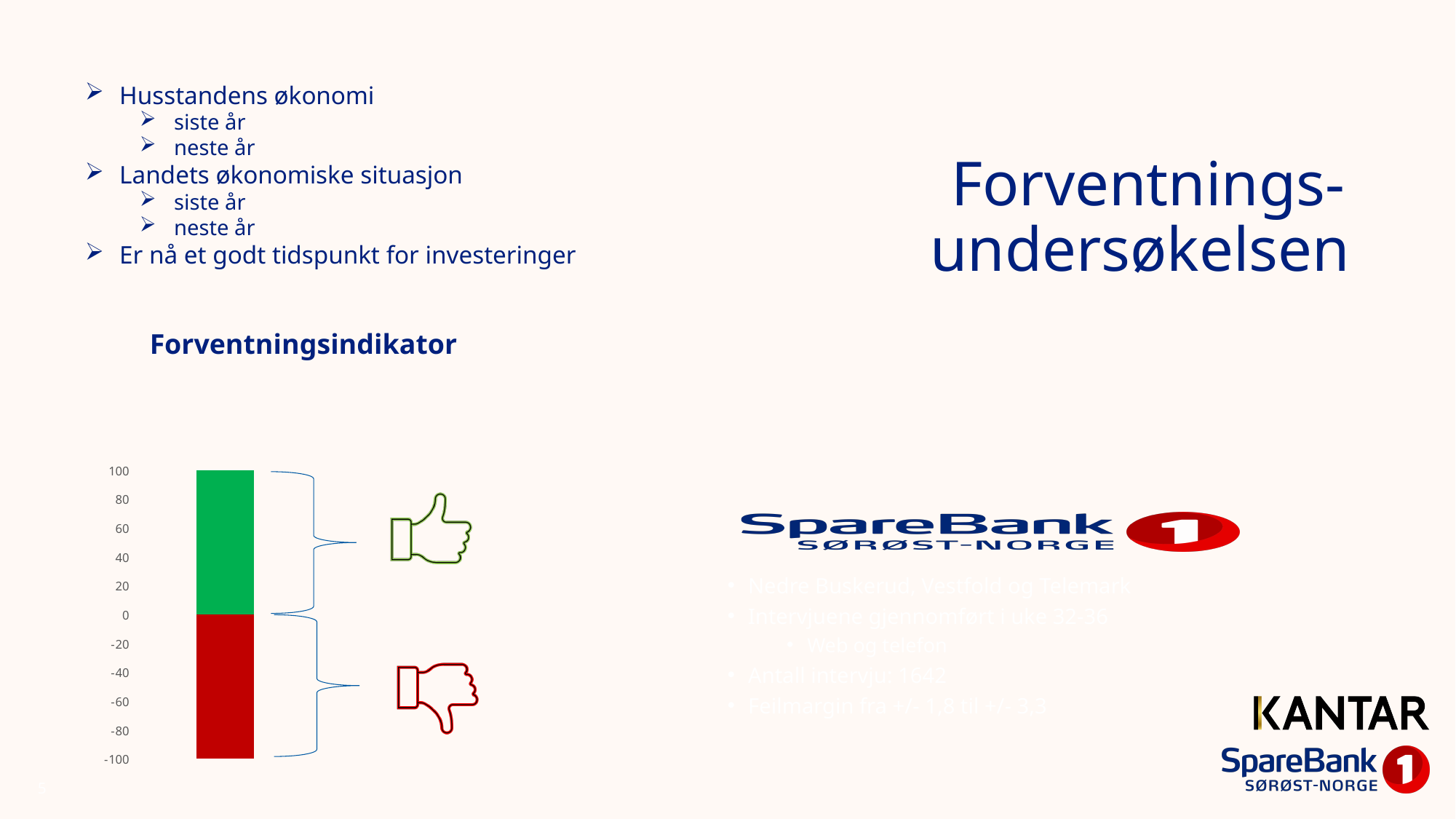
In the Forventningsindikator chart, at what axis value does the red segment end at the bottom? -100 How many bars are plotted in the Forventningsindikator chart? 1 In the Forventningsindikator chart, at what axis value do the green and red segments meet? 0 What kind of chart is shown under the heading "Forventningsindikator"? bar chart How many tick labels are shown on the vertical axis of the Forventningsindikator chart? 11 What is the lowest value shown on the vertical axis of the Forventningsindikator chart? -100 In the Forventningsindikator chart, what colour is the segment above 0? green In the Forventningsindikator chart, is the bottom of the red segment greater or less than -80? less In the Forventningsindikator chart, is the top of the green segment greater or less than 80? greater What is the highest value shown on the vertical axis of the Forventningsindikator chart? 100 In the Forventningsindikator chart, at what axis value does the green segment end at the top? 100 What is the title of the chart on the lower left of the slide? Forventningsindikator